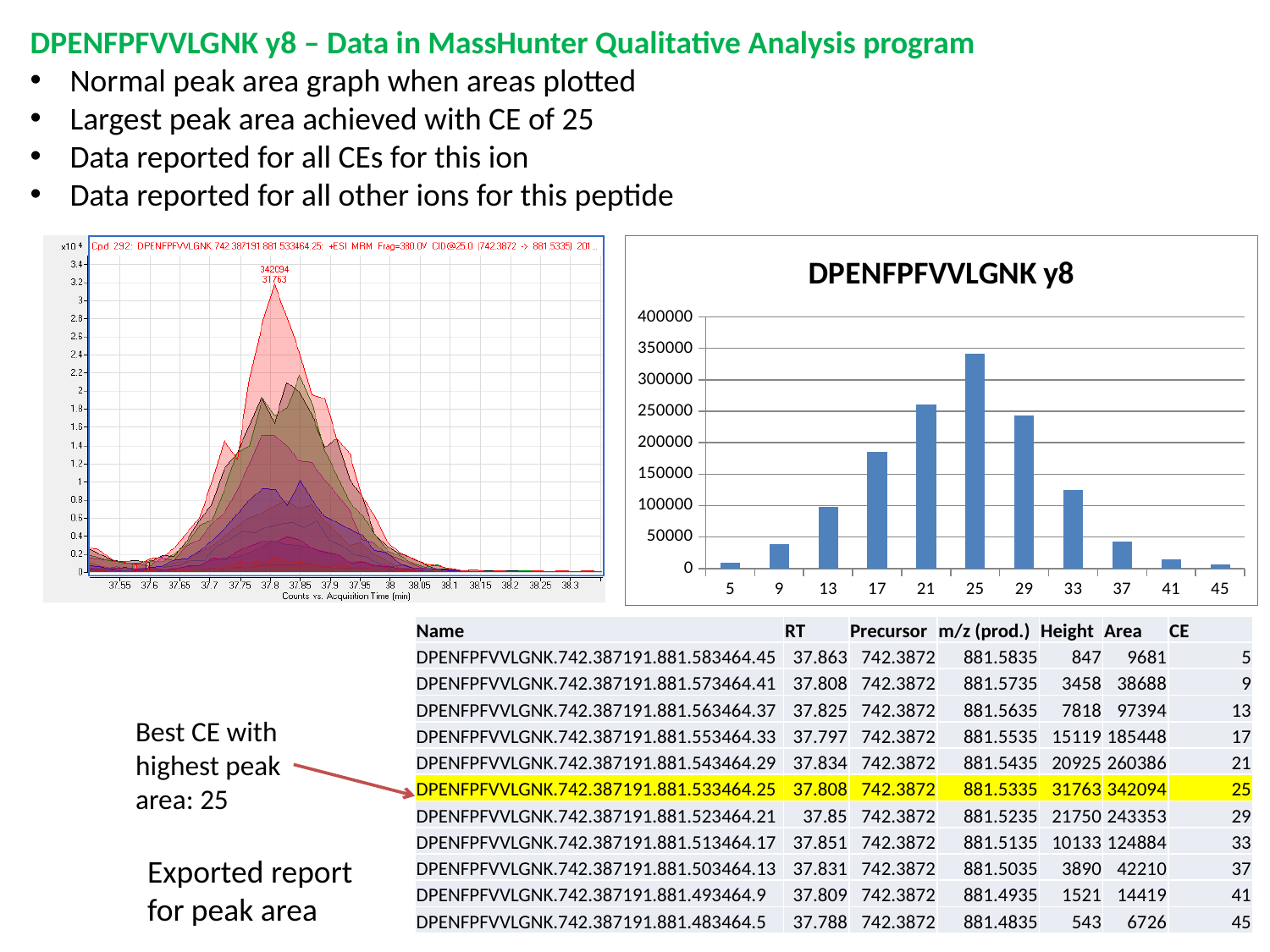
On the bar chart titled DPENFPFVVLGNK y8, which is larger, the value for CE 13 or the value for CE 37? CE 13 On the bar chart titled DPENFPFVVLGNK y8, which CE category has the highest bar? 25 On the bar chart titled DPENFPFVVLGNK y8, is the value for CE 25 greater or less than 300000? greater On the bar chart titled DPENFPFVVLGNK y8, is the value for CE 17 greater or less than 150000? greater How many CE categories are shown on the x axis of the bar chart titled DPENFPFVVLGNK y8? 11 What is the highest value shown on the y axis of the bar chart titled DPENFPFVVLGNK y8? 400000 On the bar chart titled DPENFPFVVLGNK y8, how do the values change as CE increases from 5 to 45? They rise to a peak at 25, then fall On the bar chart titled DPENFPFVVLGNK y8, is the value for CE 33 greater or less than 100000? greater On the bar chart titled DPENFPFVVLGNK y8, which is larger, the value for CE 17 or the value for CE 33? CE 17 What kind of chart is the chart on the right of the slide titled DPENFPFVVLGNK y8? bar chart